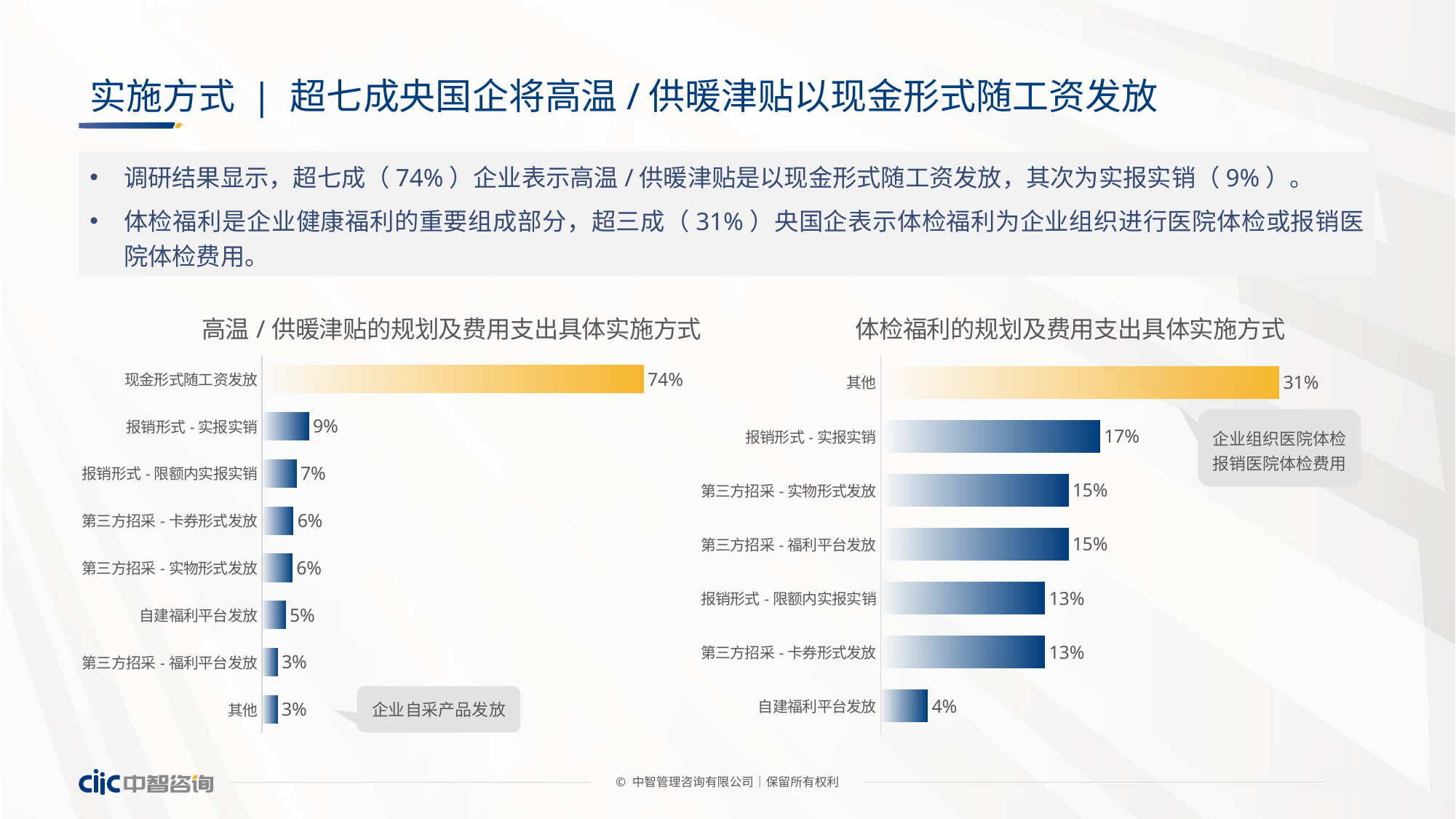
In the chart titled 体检福利的规划及费用支出具体实施方式, which category has the lowest value? 自建福利平台发放 What kind of chart is the chart titled 体检福利的规划及费用支出具体实施方式? Bar chart In the chart titled 高温 / 供暖津贴的规划及费用支出具体实施方式, what is the value for 现金形式随工资发放? 74% In the chart titled 高温 / 供暖津贴的规划及费用支出具体实施方式, what is the difference between 现金形式随工资发放 and 报销形式 - 实报实销? 65% In the chart titled 高温 / 供暖津贴的规划及费用支出具体实施方式, what is the value for 报销形式 - 限额内实报实销? 7% How many categories are shown in the chart titled 高温 / 供暖津贴的规划及费用支出具体实施方式? 8 In the chart titled 体检福利的规划及费用支出具体实施方式, which is larger: 报销形式 - 实报实销 or 报销形式 - 限额内实报实销? 报销形式 - 实报实销 In the chart titled 体检福利的规划及费用支出具体实施方式, what is the difference between 其他 and 自建福利平台发放? 27% How many categories are shown in the chart titled 体检福利的规划及费用支出具体实施方式? 7 In the chart titled 体检福利的规划及费用支出具体实施方式, what is the value for 报销形式 - 实报实销? 17% In the chart titled 高温 / 供暖津贴的规划及费用支出具体实施方式, which category has the highest value? 现金形式随工资发放 In the chart titled 体检福利的规划及费用支出具体实施方式, what is the value for 其他? 31%